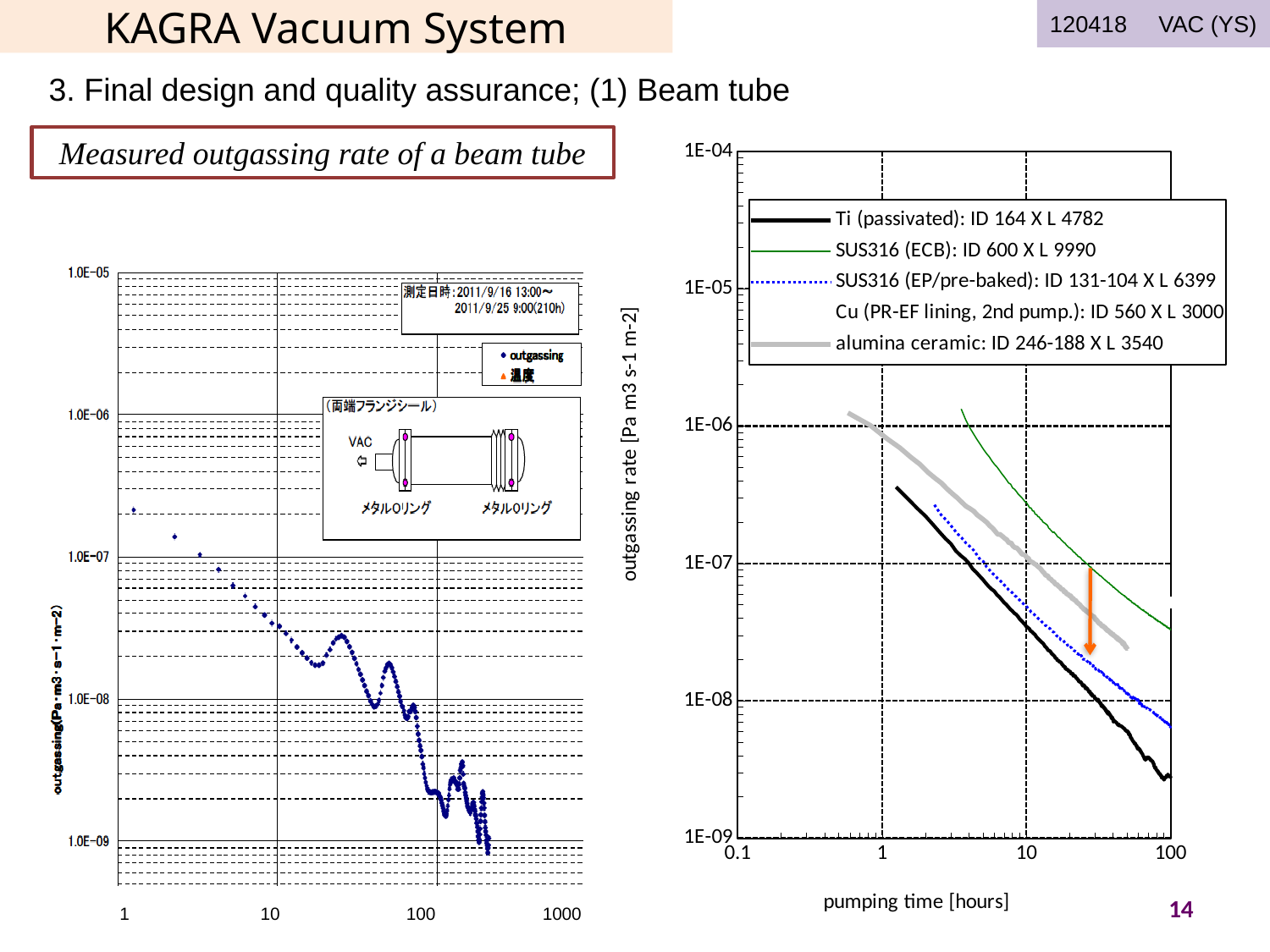
What kind of chart is the left-hand chart titled 'Measured outgassing rate of a beam tube'? scatter plot What is the x-axis label of the right-hand chart? pumping time [hours] In the right-hand chart, do the outgassing rates rise or fall as pumping time increases? fall In the right-hand chart, at 10 hours which has the higher outgassing rate, SUS316 (ECB) or Ti (passivated)? SUS316 (ECB) What kind of chart is the right-hand chart with the legend listing Ti (passivated), SUS316 and alumina ceramic? line chart In the right-hand chart, which plotted series has the lowest outgassing rate at 10 hours of pumping time? Ti (passivated): ID 164 X L 4782 In the right-hand chart, which series has the highest outgassing rate at 10 hours of pumping time? SUS316 (ECB): ID 600 X L 9990 In the left-hand chart 'Measured outgassing rate of a beam tube', does the outgassing rate rise or fall as time increases along the x axis? fall In the right-hand chart, at 100 hours is the outgassing rate of SUS316 (ECB) greater or less than 1E-08? greater In the left-hand chart 'Measured outgassing rate of a beam tube', is the outgassing value at x = 10 greater or less than 1.0E-07? less In the right-hand chart, at 100 hours is the outgassing rate of Ti (passivated) greater or less than 1E-08? less How many series does the legend of the right-hand chart list? 5